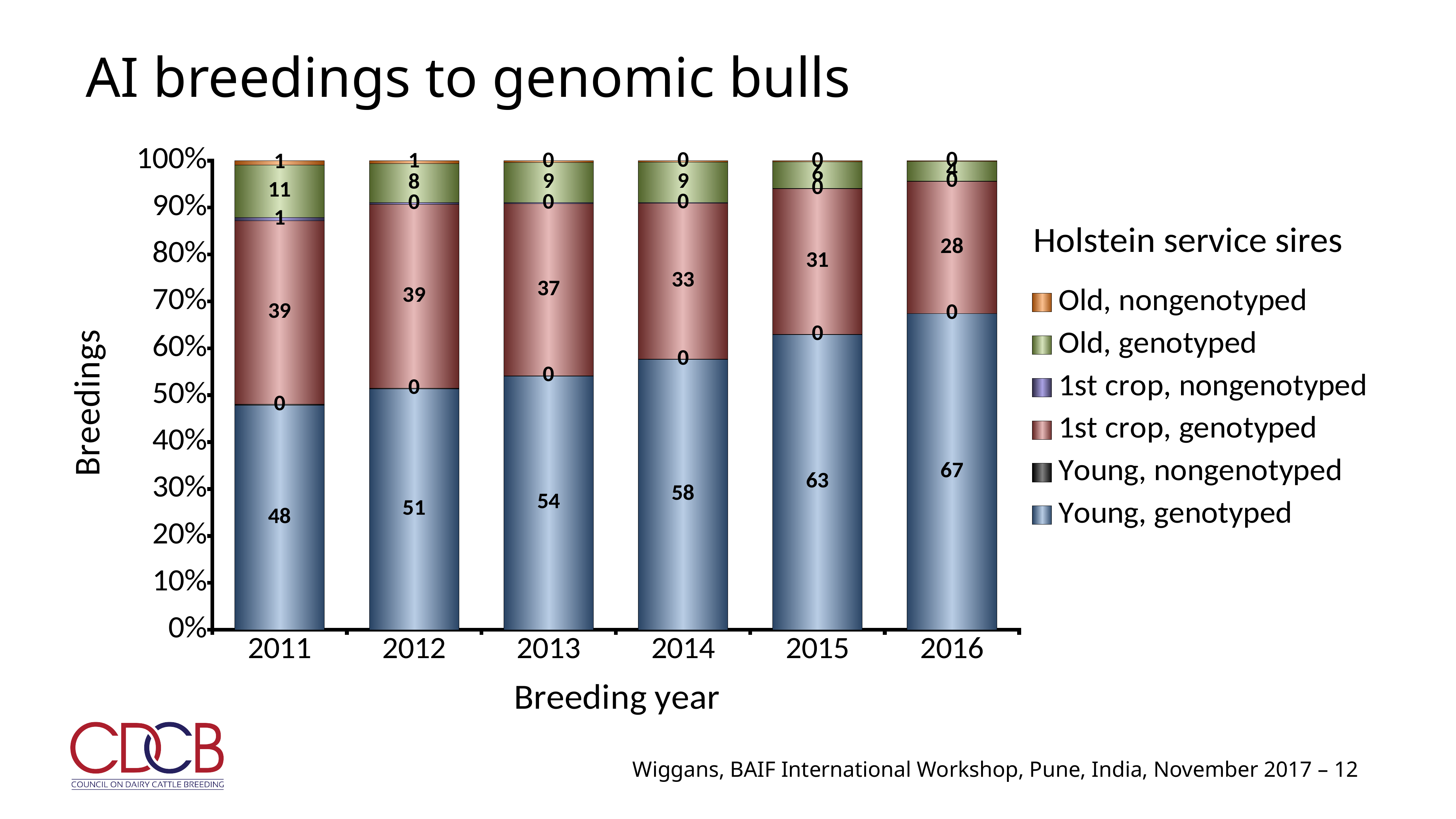
Which is larger in 2014: Young, genotyped or 1st crop, genotyped? Young, genotyped What is the value for Young, genotyped in 2011? 48 What is the value for Old, genotyped in 2012? 8 Does the Young, genotyped value rise or fall from 2011 to 2016? Rise In which year is the Young, genotyped value highest? 2016 How many series does the legend list? 6 What is the difference between the Young, genotyped values for 2016 and 2011? 19 What kind of chart is shown? Stacked bar chart What is the value for 1st crop, genotyped in 2013? 37 How many breeding years are shown on the x axis? 6 What is the value for Young, genotyped in 2016? 67 In which year is the 1st crop, genotyped value lowest? 2016